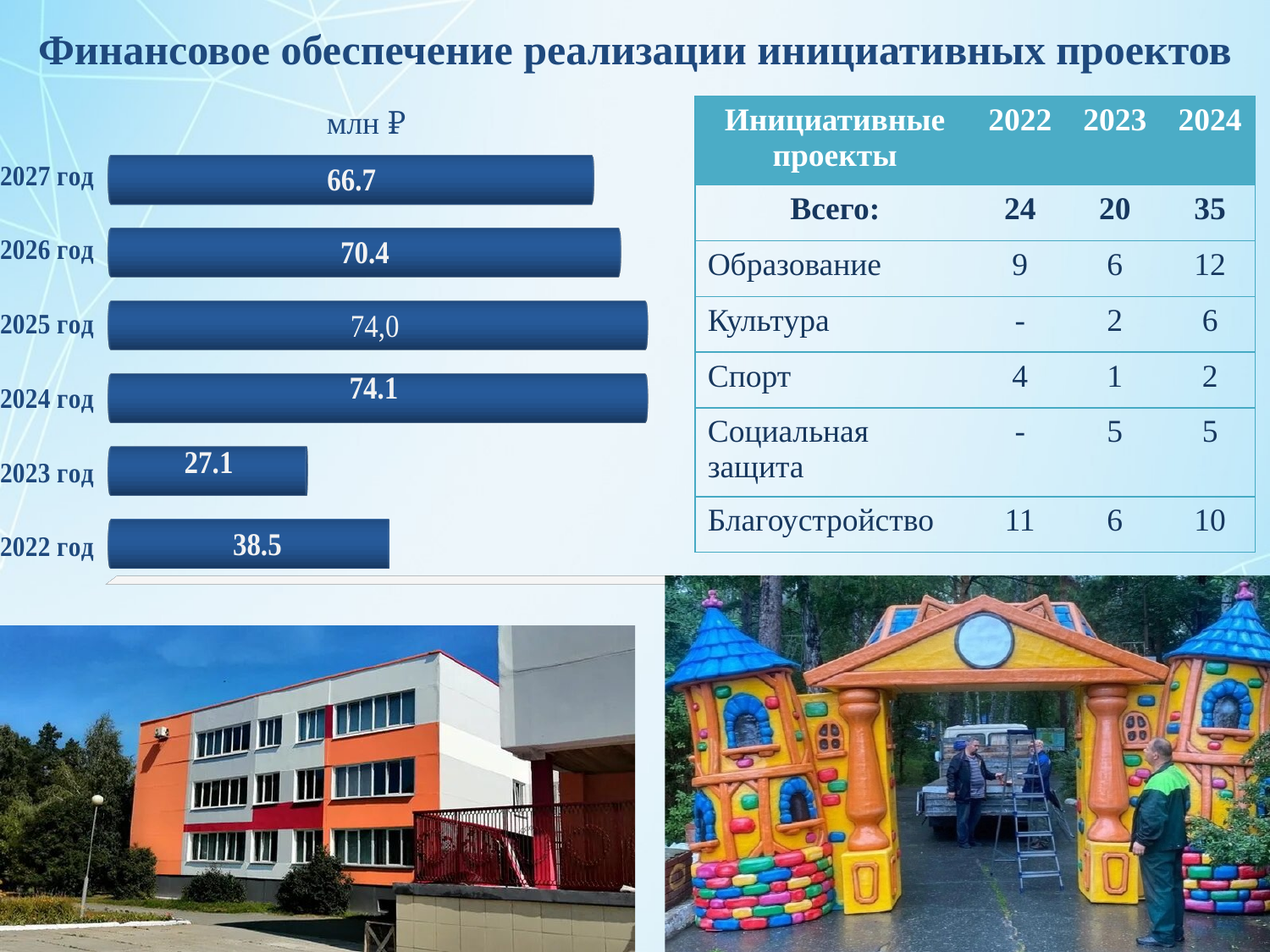
Which is larger in the bar chart, the value for 2022 год or 2023 год? 2022 год What kind of chart is shown on the left of the slide? Bar chart What is the value for 2026 год in the bar chart? 70.4 What is the difference between the values for 2024 год and 2023 год in the bar chart? 47.0 Which year has the lowest value in the bar chart? 2023 год Which is larger in the bar chart, the value for 2026 год or 2027 год? 2026 год What unit is indicated above the bar chart? млн ₽ How many years (bars) are shown in the bar chart? 6 What is the difference between the values for 2022 год and 2023 год in the bar chart? 11.4 What is the value for 2022 год in the bar chart? 38.5 What is the value for 2023 год in the bar chart? 27.1 What is the value for 2027 год in the bar chart? 66.7